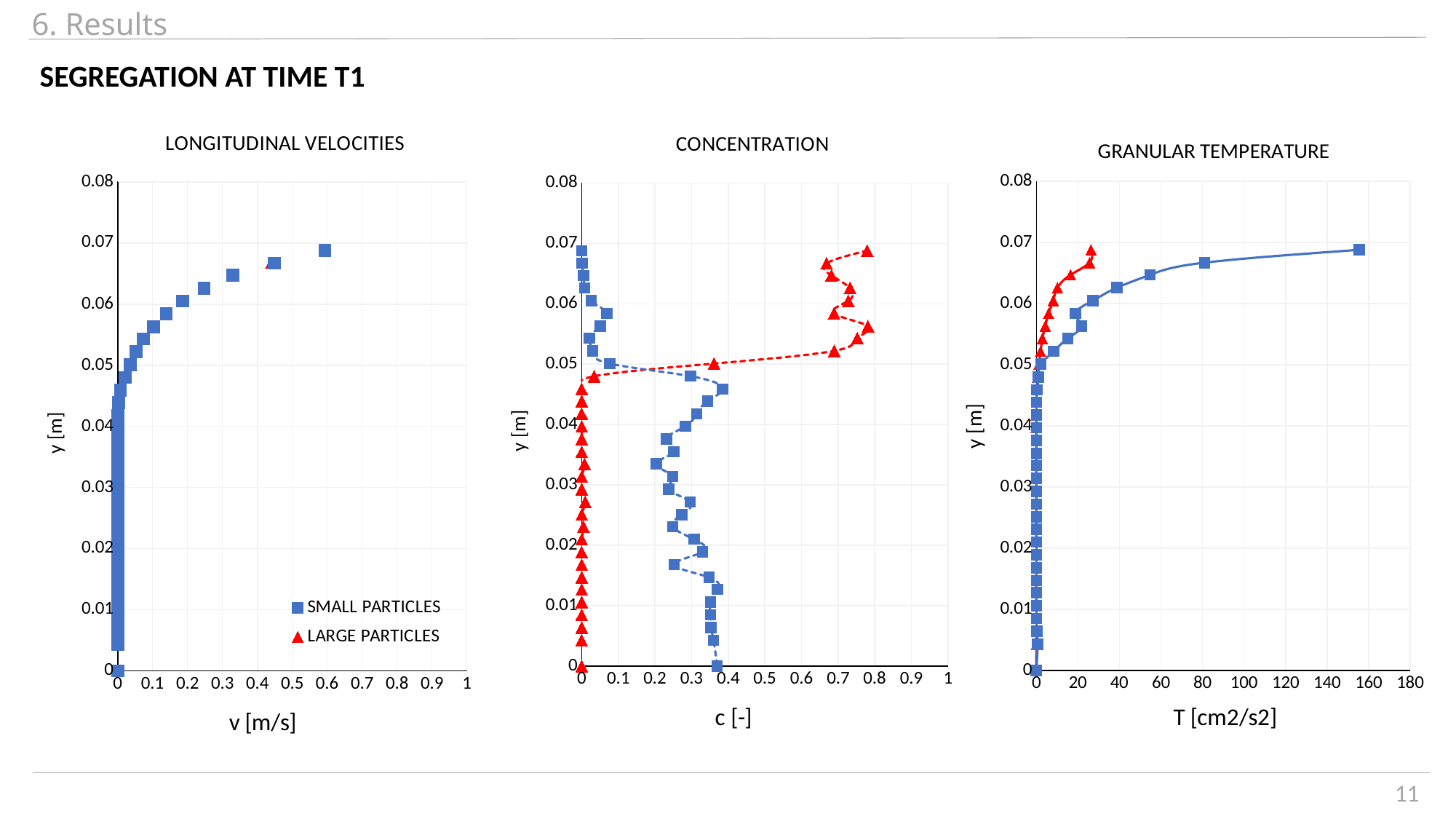
In the CONCENTRATION chart, is the concentration of LARGE PARTICLES at y = 0.02 greater or less than 0.1? less What is the x-axis label of the CONCENTRATION chart? c [-] In the GRANULAR TEMPERATURE chart, at y = 0.065, which series has the larger T value, SMALL PARTICLES or LARGE PARTICLES? SMALL PARTICLES In the LONGITUDINAL VELOCITIES chart, does the velocity of SMALL PARTICLES increase or decrease as y increases? increase In the CONCENTRATION chart, at y = 0.03, which series has the larger concentration, SMALL PARTICLES or LARGE PARTICLES? SMALL PARTICLES In the GRANULAR TEMPERATURE chart, is the highest T value for SMALL PARTICLES greater or less than 140? greater In the CONCENTRATION chart, is the concentration of SMALL PARTICLES at y = 0 greater or less than 0.3? greater What kind of chart is the LONGITUDINAL VELOCITIES chart? scatter chart What is the x-axis label of the GRANULAR TEMPERATURE chart? T [cm2/s2] How many series does the legend on the LONGITUDINAL VELOCITIES chart list? 2